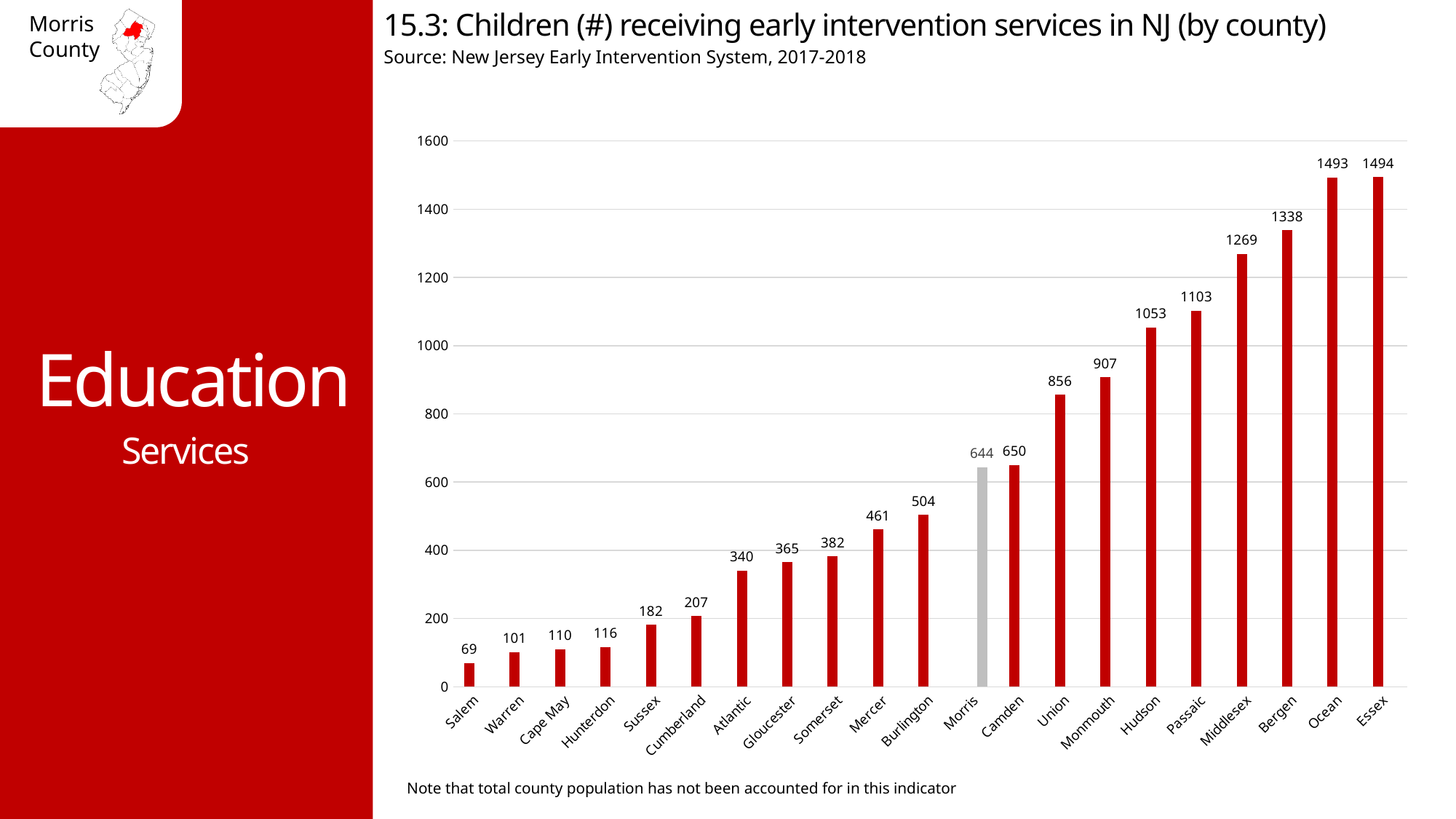
Which county has a higher value, Union or Monmouth? Monmouth What is the value shown for Cumberland County? 207 How many counties are shown on the chart? 21 What is the difference between the values for Bergen and Middlesex? 69 What is the difference between the values for Camden and Morris? 6 What kind of chart is shown on the slide? Bar chart Is the value for Passaic greater or less than 1000? greater Which county has a higher value, Mercer or Burlington? Burlington Which county's bar is shown in grey rather than red? Morris How many children received early intervention services in Morris County? 644 Which county has the lowest number of children receiving early intervention services? Salem What is the value shown for Hudson County? 1053